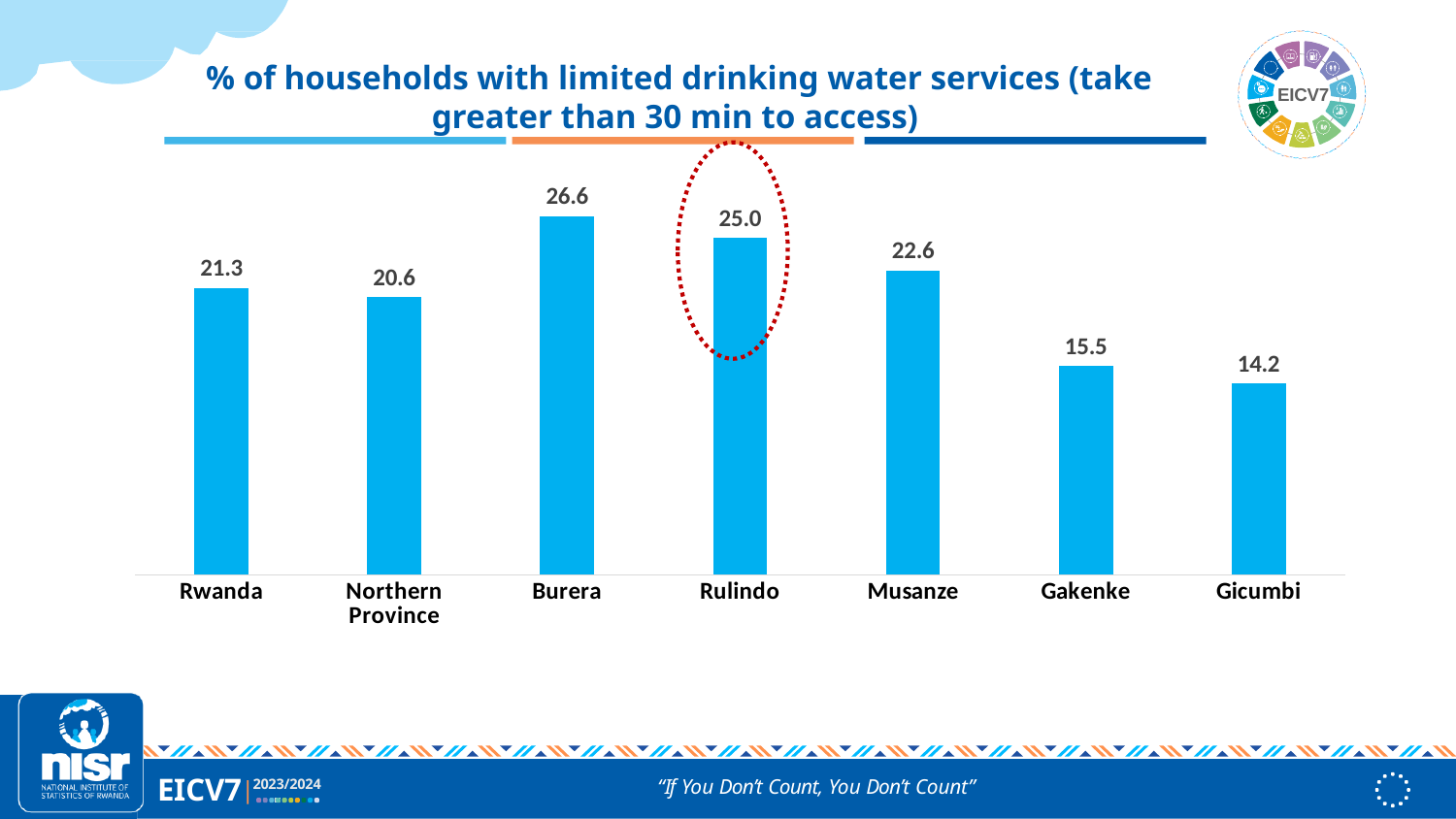
What is the value for Rulindo? 25.0 What is the value for Gicumbi? 14.2 Which is larger, the value for Musanze or the value for Rwanda? Musanze What is the difference between the values for Burera and Rulindo? 1.6 What kind of chart is shown on the slide? Bar chart Which category is highlighted with a red dotted circle? Rulindo Which category has the highest value? Burera What is the difference between the values for Rwanda and Gakenke? 5.8 What is the value for Northern Province? 20.6 How many categories are shown on the x axis? 7 Which category has the lowest value? Gicumbi What is the value for Burera? 26.6